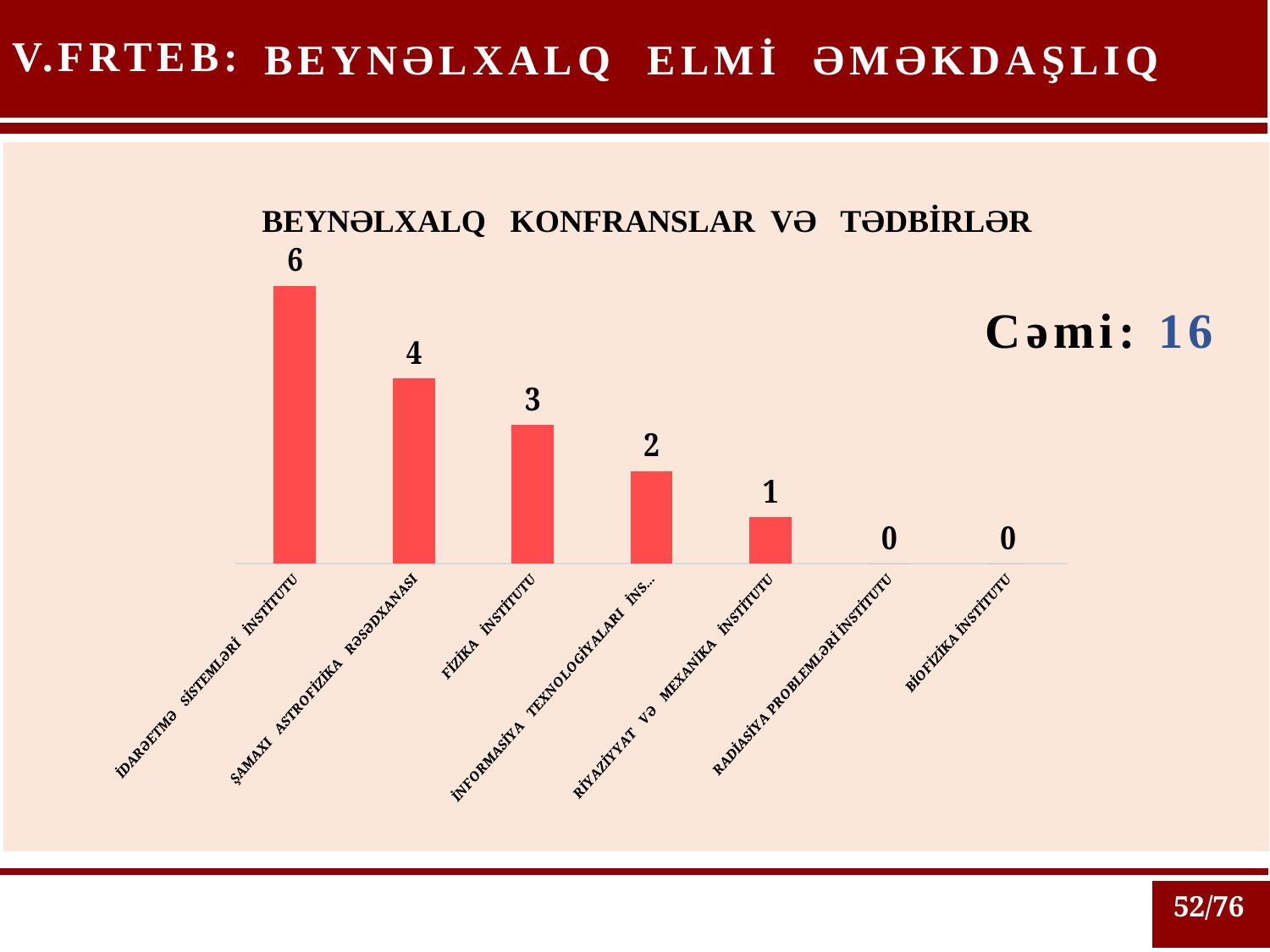
Which is larger, the value for ŞAMAXI ASTROFİZİKA RƏSƏDXANASI or the value for RİYAZİYYAT VƏ MEXANİKA İNSTİTUTU? ŞAMAXI ASTROFİZİKA RƏSƏDXANASI What is the value for BİOFİZİKA İNSTİTUTU? 0 What is the value for ŞAMAXI ASTROFİZİKA RƏSƏDXANASI? 4 Which category has the highest value? İDARƏETMƏ SİSTEMLƏRİ İNSTİTUTU What kind of chart is shown on the slide? bar chart Do the values rise or fall from left to right along the x axis? fall What total (Cəmi) is shown next to the chart? 16 How many categories are shown in the chart? 7 What is the title of the chart? BEYNƏLXALQ KONFRANSLAR VƏ TƏDBİRLƏR What is the value for RİYAZİYYAT VƏ MEXANİKA İNSTİTUTU? 1 What is the difference between the values for İDARƏETMƏ SİSTEMLƏRİ İNSTİTUTU and FİZİKA İNSTİTUTU? 3 What is the value for FİZİKA İNSTİTUTU? 3